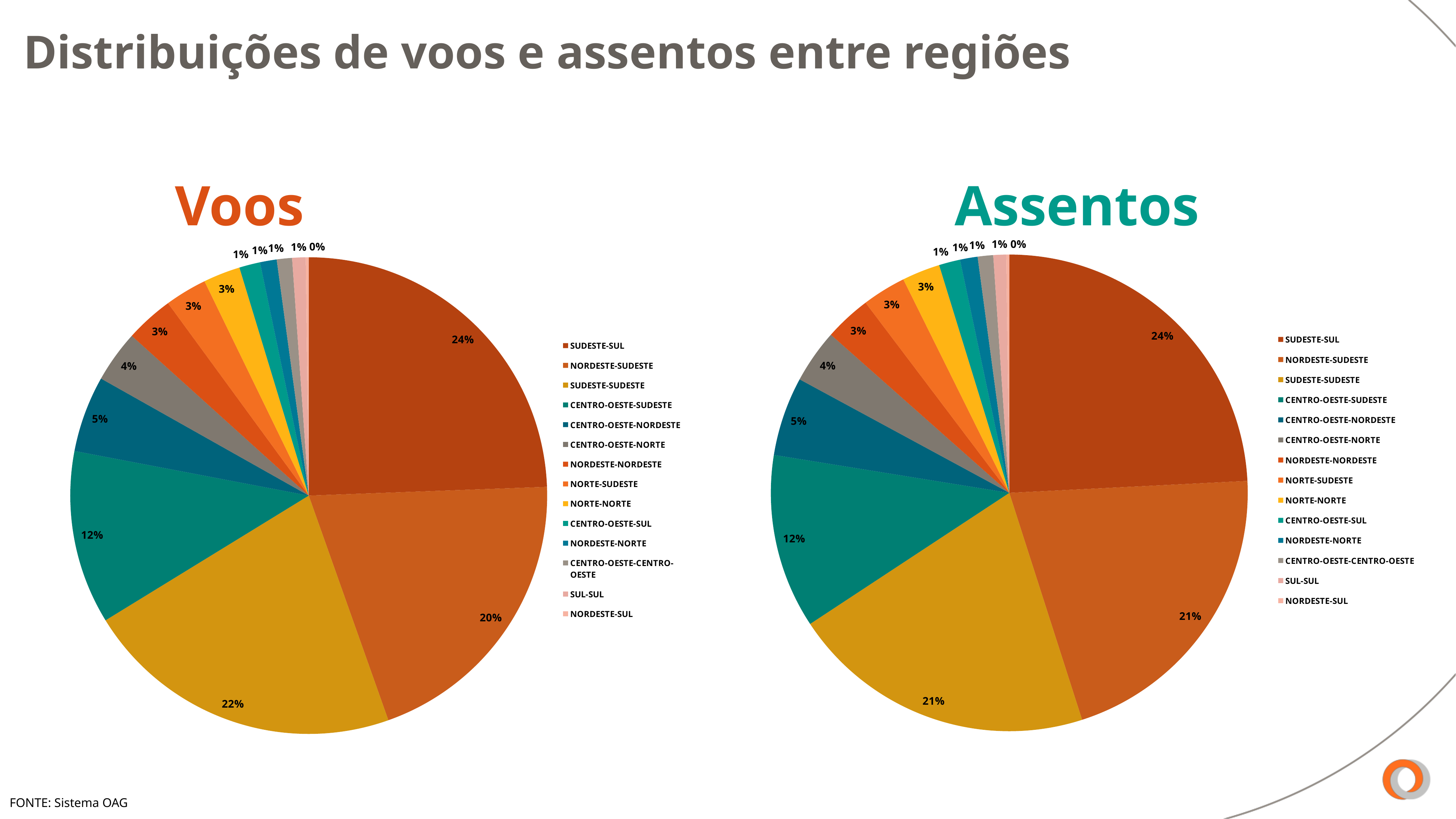
In the Voos chart, what share does SUDESTE-SUL have? 24% In the Voos chart, what is the difference between the shares of SUDESTE-SUL and CENTRO-OESTE-SUDESTE? 12% What type of chart is used for the Voos chart? pie chart In the Assentos chart, what share does NORDESTE-SUDESTE have? 21% In the Voos chart, what share does SUDESTE-SUDESTE have? 22% In the Voos chart, what share does NORDESTE-SUDESTE have? 20% In the Assentos chart, what share does CENTRO-OESTE-NORDESTE have? 5% In the Assentos chart, what share does CENTRO-OESTE-SUDESTE have? 12% In the Voos chart, which category has the largest share? SUDESTE-SUL In the Assentos chart, which category has the largest share? SUDESTE-SUL How many categories does the legend of the Assentos chart list? 14 In the Voos chart, which is larger: the share of SUDESTE-SUDESTE or NORDESTE-SUDESTE? SUDESTE-SUDESTE